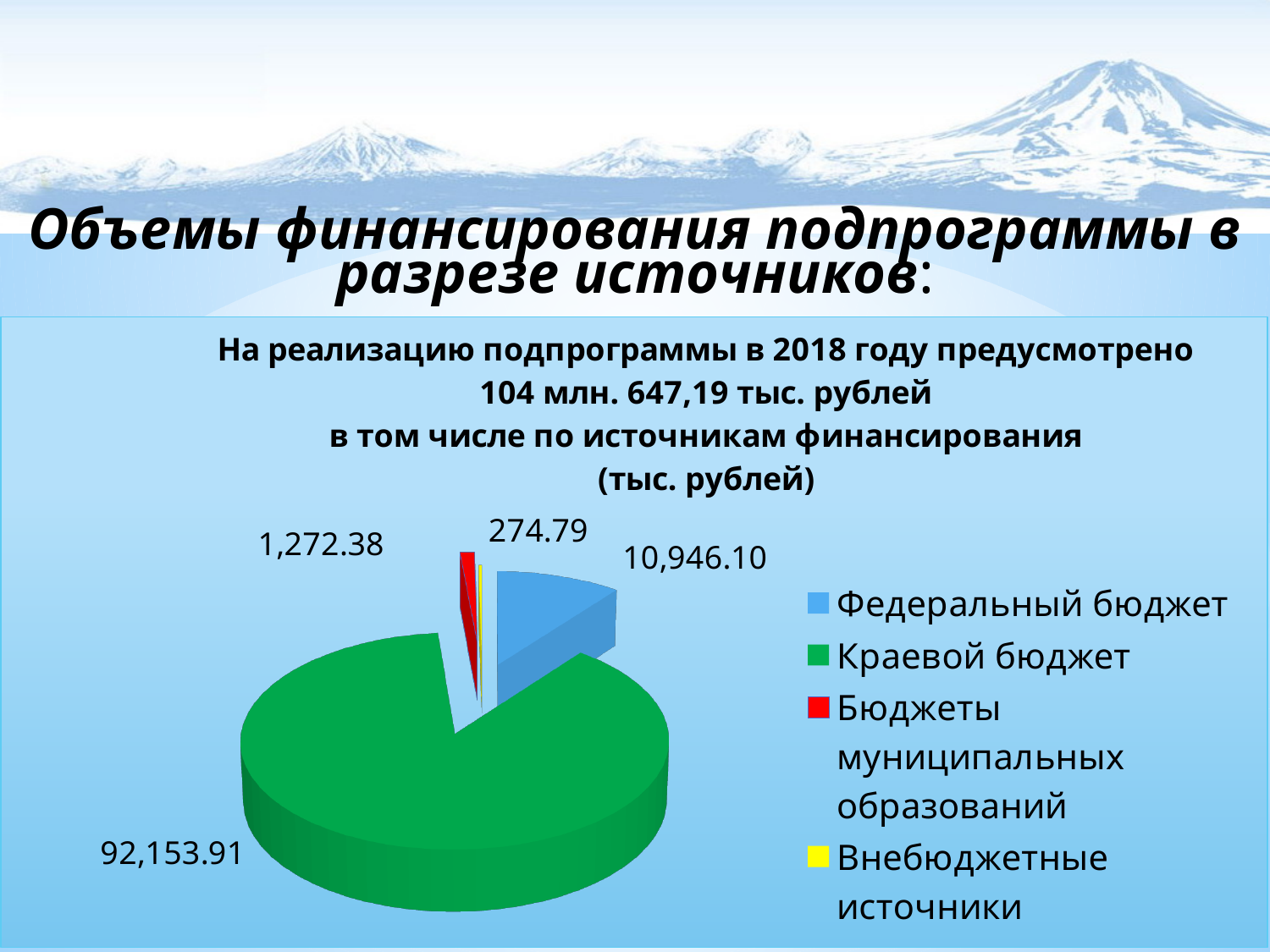
What type of chart is shown on the slide? Pie chart What colour represents Краевой бюджет in the pie chart? Green What is the difference between the values for Краевой бюджет and Федеральный бюджет? 81,207.81 What is the value for Краевой бюджет in the pie chart? 92,153.91 What is the value for Внебюджетные источники in the pie chart? 274.79 Which is larger: the value for Федеральный бюджет or the value for Бюджеты муниципальных образований? Федеральный бюджет What is the value for Федеральный бюджет in the pie chart? 10,946.10 Which funding source has the smallest slice in the pie chart? Внебюджетные источники What is the value for Бюджеты муниципальных образований in the pie chart? 1,272.38 Which funding source has the largest slice in the pie chart? Краевой бюджет What is the difference between the values for Бюджеты муниципальных образований and Внебюджетные источники? 997.59 How many categories does the legend of the pie chart list? 4